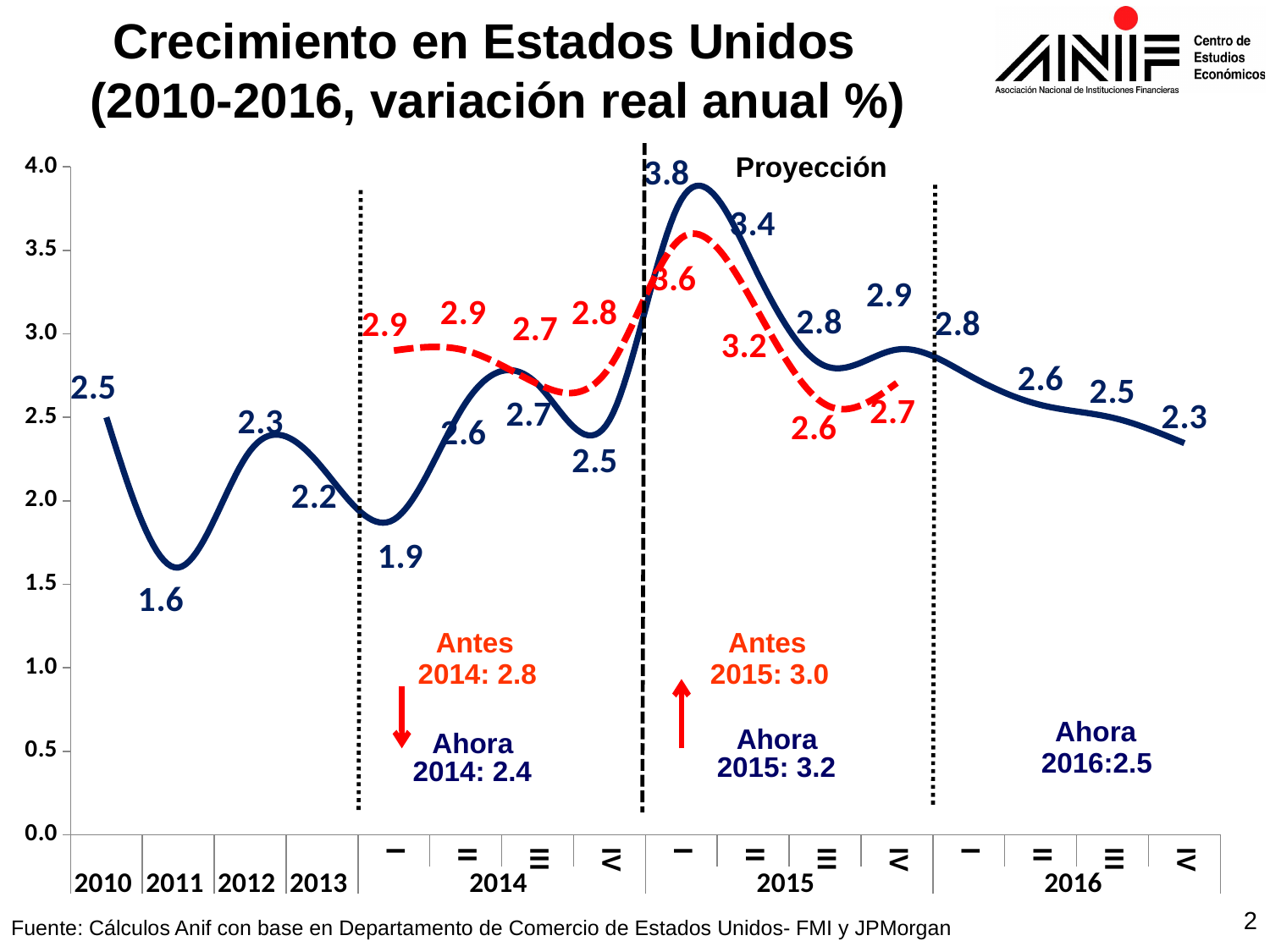
What type of chart is shown on the slide? line chart Which point on the solid blue line has the lowest value? 2011 (1.6) What is the difference between the solid blue line value for 2015 I (3.8) and the red dashed line value for 2015 I (3.6)? 0.2 Which is larger for the first quarter (I) of 2014: the solid blue line value or the red dashed line value? the red dashed line (2.9) What is the value of the solid blue line for the first quarter (I) of 2015? 3.8 What is the difference between the 'Antes 2014' figure (2.8) and the 'Ahora 2014' figure (2.4)? 0.4 Do the values of the solid blue line rise or fall from 2016 I to 2016 IV? fall What is the value of the solid blue line for 2011? 1.6 Which point on the solid blue line has the highest value? 2015 I (3.8) What is the value of the solid blue line for the fourth quarter (IV) of 2016? 2.3 What is the value of the red dashed line for the first quarter (I) of 2015? 3.6 According to the annotation, what is the current ('Ahora') growth figure for 2015? 3.2